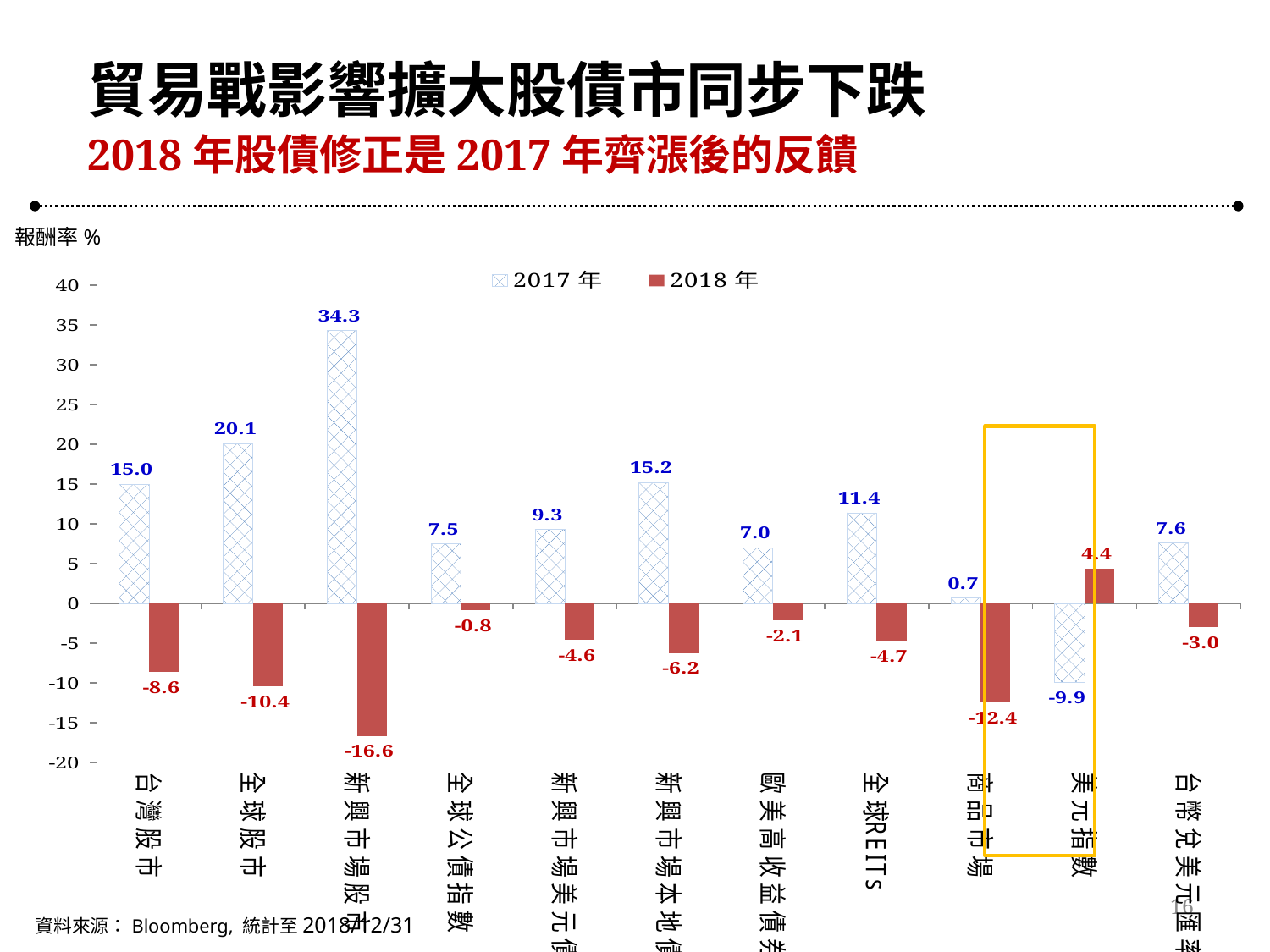
Which has the larger 2018 年 value, 台灣股市 or 全球股市? 台灣股市 How many categories are shown on the x axis? 11 Which category has the highest 2017 年 value? 新興市場股市 Which category has the highest 2018 年 value? 美元指數 What kind of chart is shown on the slide? Bar chart What is the difference between the 2017 年 and 2018 年 values for 全球股市? 30.5 What is the 2018 年 value for 新興市場股市? -16.6 What is the 2017 年 value for 台灣股市? 15.0 How many series does the legend list? 2 What is the 2018 年 value for 美元指數? 4.4 What is the 2017 年 value for 商品市場? 0.7 Which category has the lowest 2018 年 value? 新興市場股市